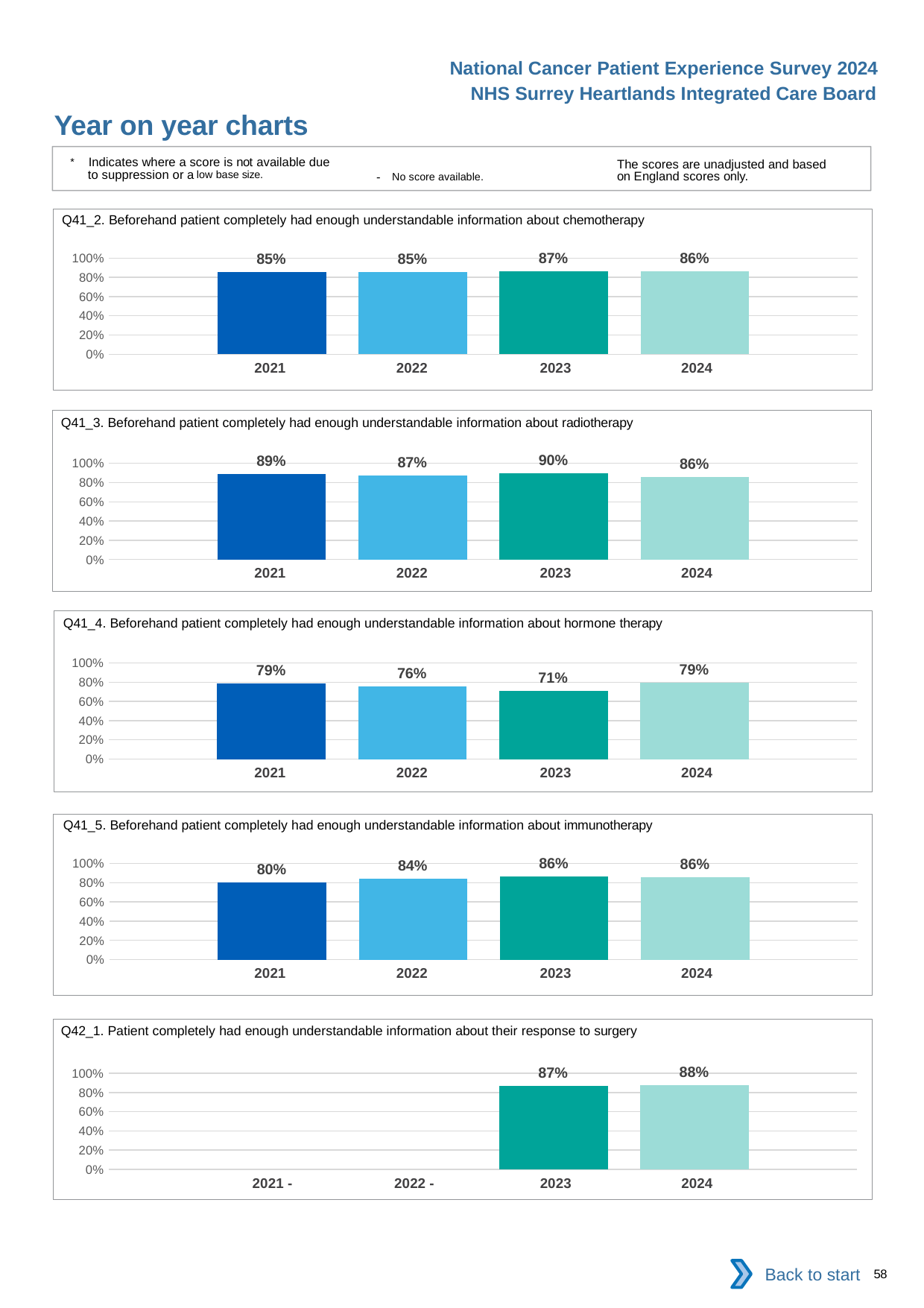
In the Q41_3 radiotherapy chart, which year has the highest value? 2023 In the Q41_4 hormone therapy chart, what is the value for 2022? 76% In the Q42_1 surgery chart, what is the value for 2024? 88% What kind of chart is the Q41_2 chemotherapy chart? bar chart In the Q41_5 immunotherapy chart, do the values rise or fall from 2021 to 2023? rise In the Q41_5 immunotherapy chart, what is the difference between the 2021 and 2023 values? 6% In the Q41_3 radiotherapy chart, what is the difference between the 2023 and 2024 values? 4% In the Q41_4 hormone therapy chart, is the value for 2023 greater or less than 80%? less In the Q41_4 hormone therapy chart, which year has the lowest value? 2023 In the Q42_1 surgery chart, how many years have a bar plotted? 2 In the Q41_2 chemotherapy chart, what is the value for 2023? 87% In the Q41_5 immunotherapy chart, is the value for 2021 larger or smaller than the value for 2022? smaller